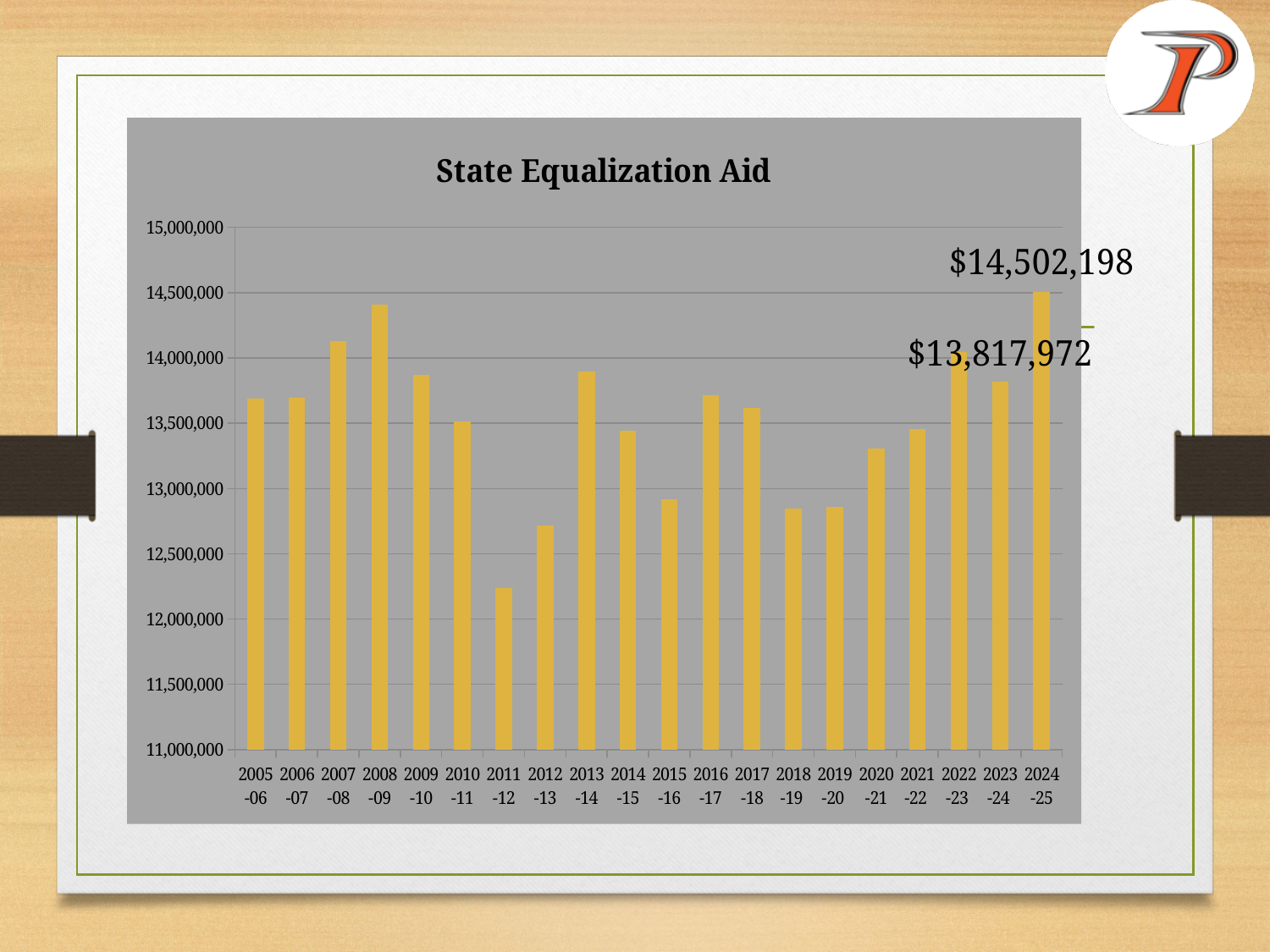
What is the difference between the labeled values for 2024-25 and 2023-24? $684,226 How many school years are plotted on the chart? 20 Is the value for 2011-12 greater or less than 12,500,000? less What is the State Equalization Aid value labeled for 2024-25? $14,502,198 Which year has the highest State Equalization Aid? 2024-25 Which is larger, the value for 2008-09 or the value for 2007-08? 2008-09 What kind of chart is shown on the slide? bar chart What is the title of the chart? State Equalization Aid What is the State Equalization Aid value labeled for 2023-24? $13,817,972 Which year has the lowest State Equalization Aid? 2011-12 Is the value for 2008-09 greater or less than 14,000,000? greater Do the values rise or fall from 2019-20 to 2024-25? rise